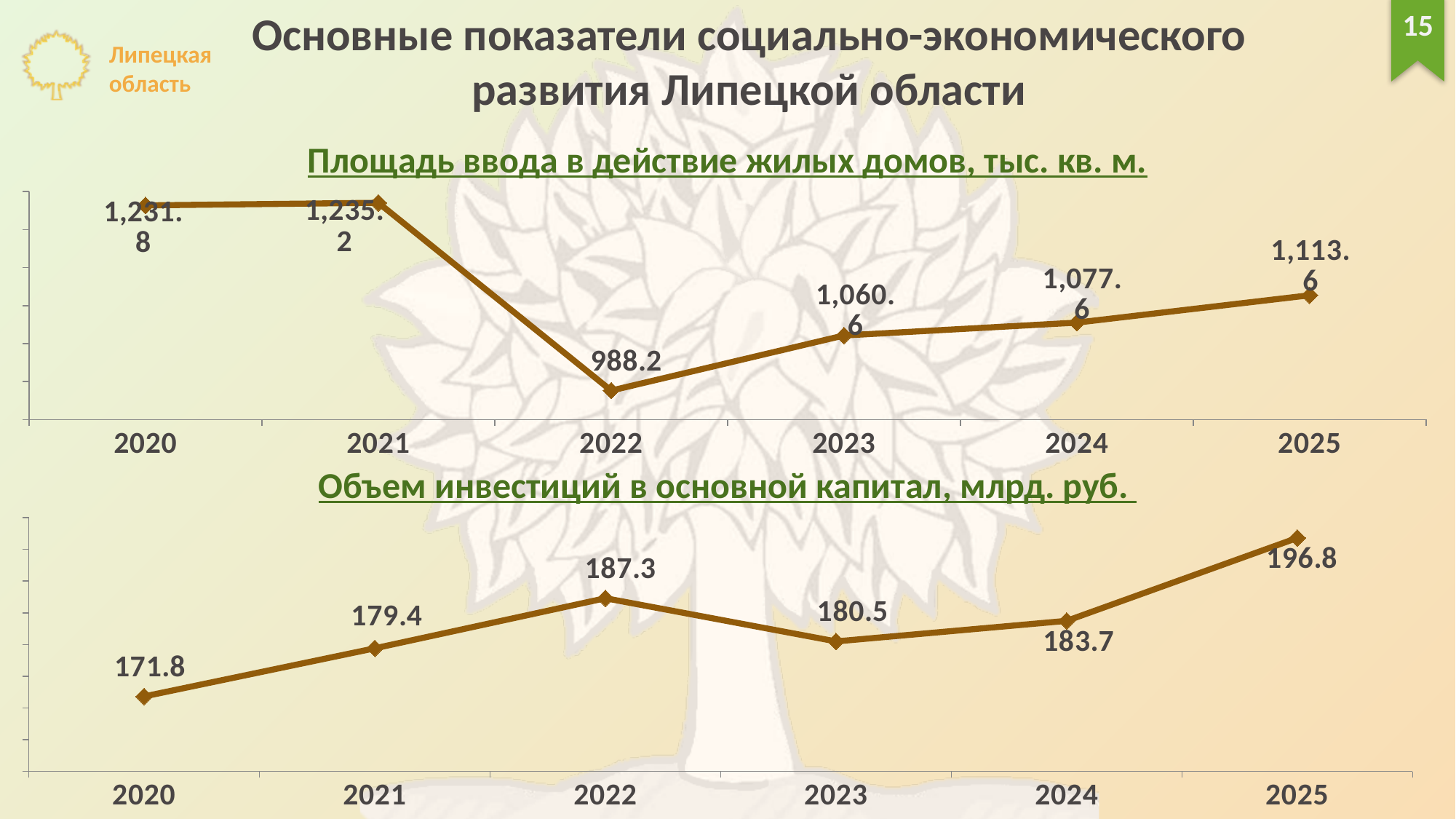
In the chart 'Площадь ввода в действие жилых домов, тыс. кв. м.', how many data points are plotted? 6 In the chart 'Площадь ввода в действие жилых домов, тыс. кв. м.', which year has the lowest value? 2022 In the chart 'Объем инвестиций в основной капитал, млрд. руб.', what is the value for 2023? 180.5 What type of chart is the bottom chart on the slide? Line chart In the chart 'Объем инвестиций в основной капитал, млрд. руб.', what is the value for 2020? 171.8 In the chart 'Объем инвестиций в основной капитал, млрд. руб.', what is the difference between the values for 2025 and 2020? 25.0 In the chart 'Объем инвестиций в основной капитал, млрд. руб.', which is larger, the value for 2022 or the value for 2024? 2022 In the chart 'Площадь ввода в действие жилых домов, тыс. кв. м.', which year has the highest value? 2021 In the chart 'Объем инвестиций в основной капитал, млрд. руб.', which year has the highest value? 2025 In the chart 'Площадь ввода в действие жилых домов, тыс. кв. м.', what is the difference between the values for 2024 and 2023? 17.0 In the chart 'Площадь ввода в действие жилых домов, тыс. кв. м.', what is the value for 2025? 1,113.6 In the chart 'Площадь ввода в действие жилых домов, тыс. кв. м.', what is the value for 2022? 988.2